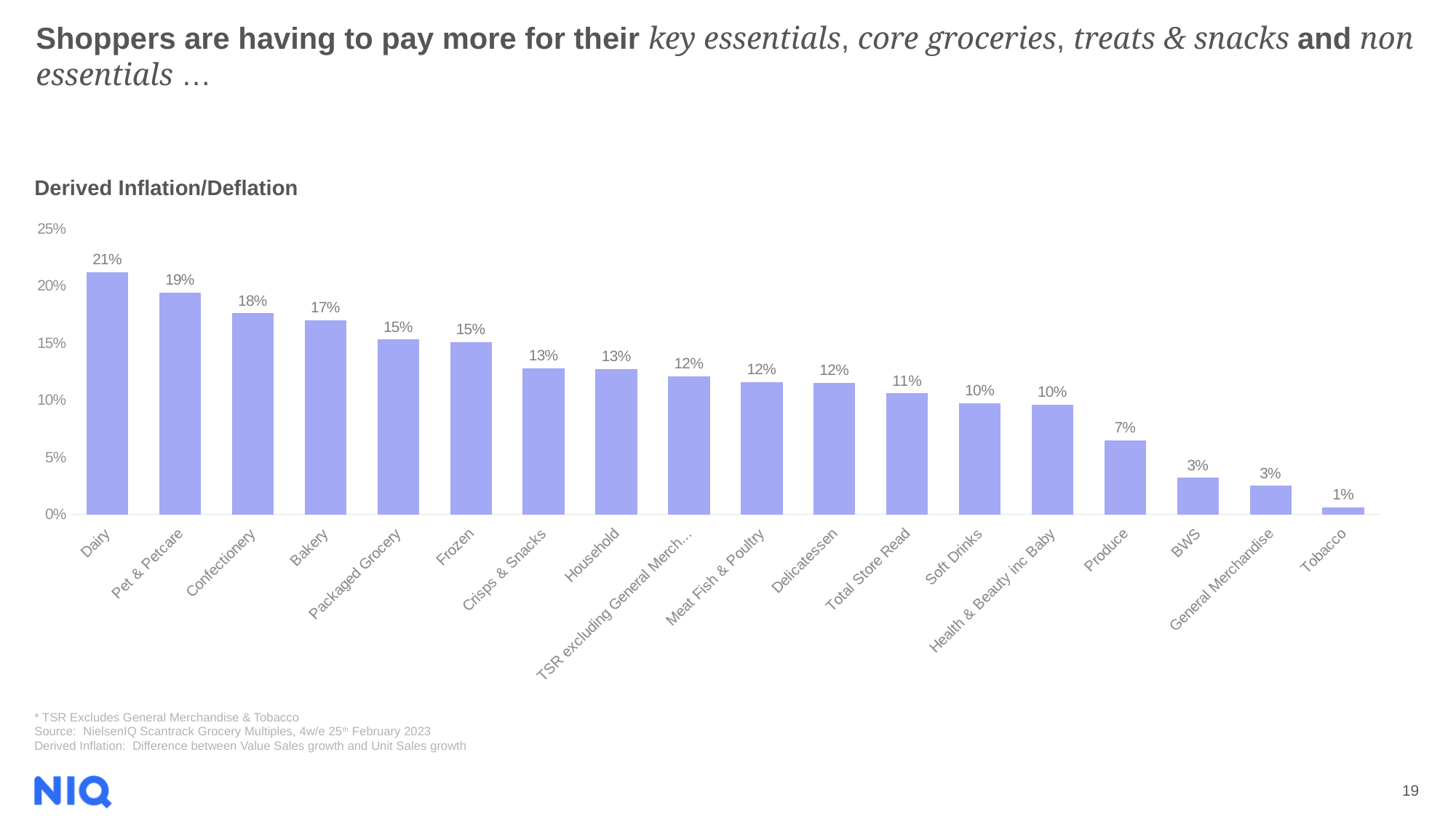
What is the derived inflation value for Produce? 7% Which has a higher derived inflation, Household or BWS? Household What is the derived inflation value for Total Store Read? 11% How many categories are shown in the chart? 18 Do the values rise or fall moving from left to right along the x axis? Fall What is the difference between the derived inflation for Confectionery and for Soft Drinks? 8% What is the derived inflation value for Bakery? 17% Which category has the lowest derived inflation? Tobacco Which category has the highest derived inflation? Dairy What kind of chart is shown on the slide? Bar chart What is the derived inflation value for Dairy? 21% What is the difference between the derived inflation for Dairy and for Pet & Petcare? 2%